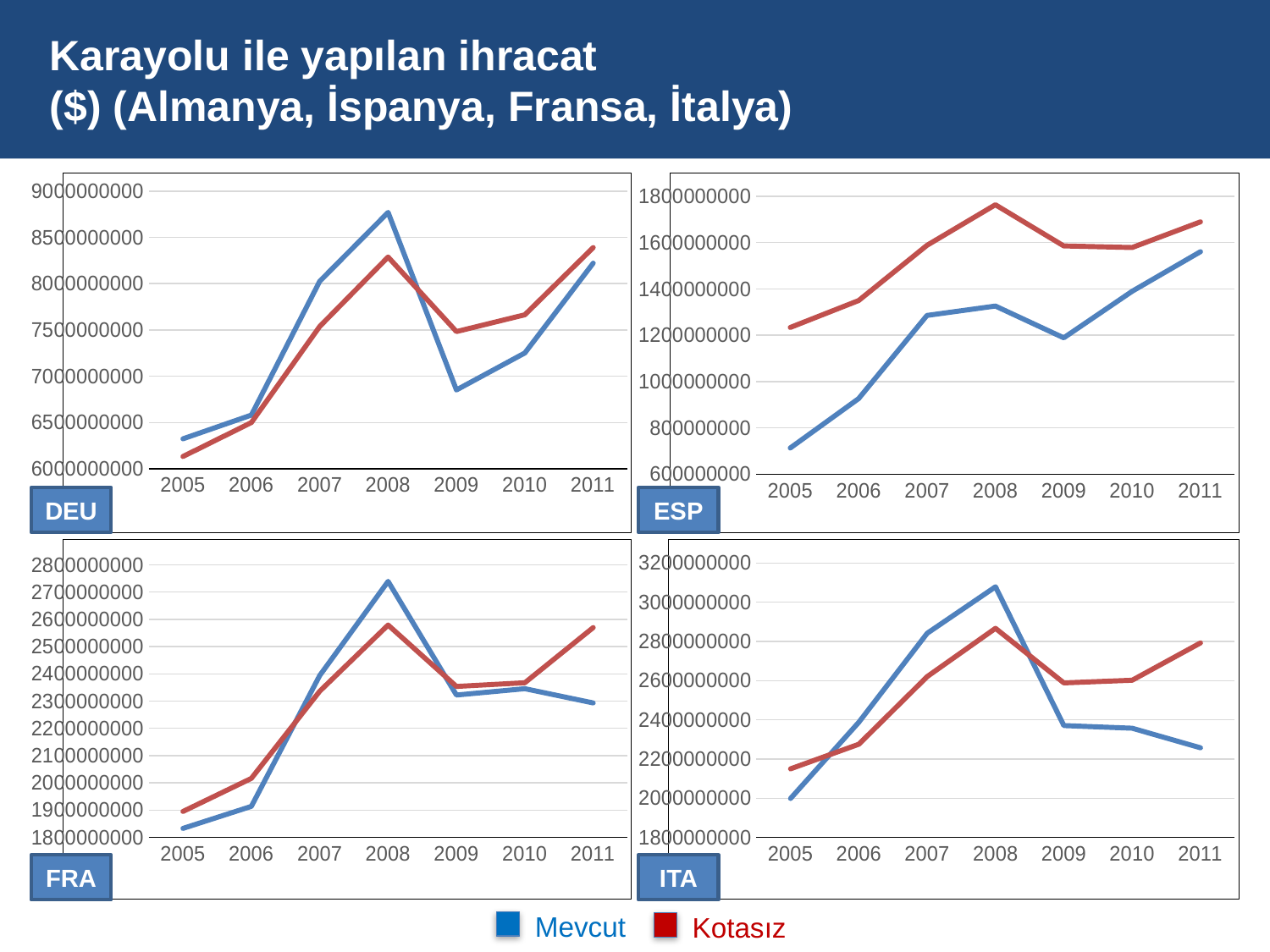
In the FRA chart, in which year does the Mevcut series reach its highest value? 2008 In the DEU chart, is the Mevcut value for 2009 greater or less than 7000000000? less In the ESP chart, in which year does the Kotasız series reach its highest value? 2008 How many series does the legend at the bottom of the slide list? 2 In the ITA chart, does the Mevcut series rise or fall from 2008 to 2011? fall How many years are plotted on the x axis of the ESP chart? 7 What kind of chart is the DEU chart? line chart In the DEU chart, is the Mevcut value for 2008 greater or less than 8500000000? greater In the DEU chart, in which year does the Mevcut series reach its highest value? 2008 In the ITA chart, is the Mevcut value for 2008 greater or less than 3000000000? greater In the ESP chart, which series has the larger value in 2011, Mevcut or Kotasız? Kotasız